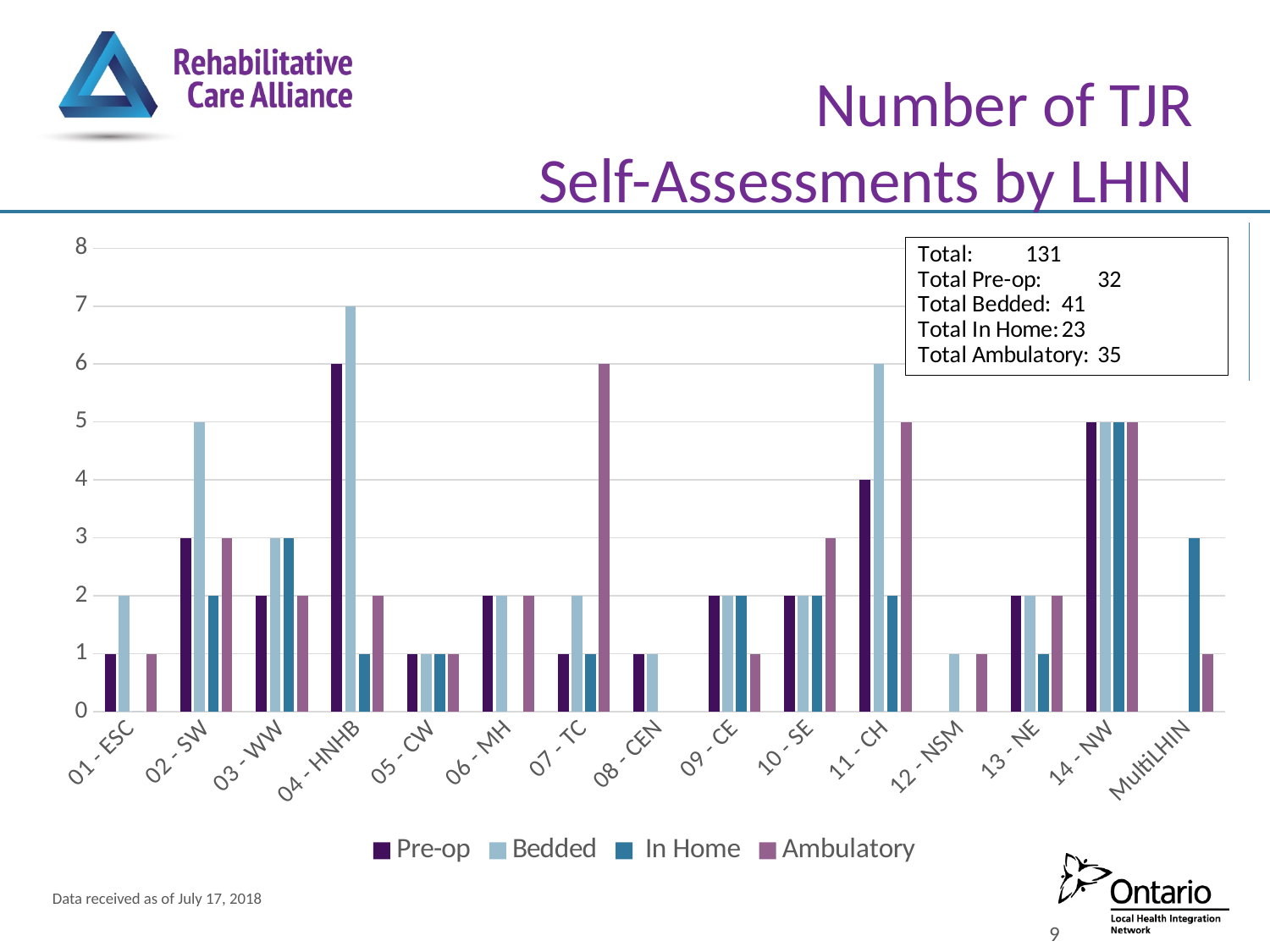
How many LHIN categories are shown along the x axis? 15 Which LHIN has the highest Bedded value? 04 - HNHB How many series does the legend list? 4 What is the Bedded value for 04 - HNHB? 7 Which is larger for 02 - SW, the Bedded value or the In Home value? Bedded What is the title of the chart? Number of TJR Self-Assessments by LHIN What kind of chart is shown on the slide? bar chart What is the difference between the Bedded value and the Pre-op value for 04 - HNHB? 1 What is the Pre-op value for 11 - CH? 4 What is the In Home value for MultiLHIN? 3 According to the text box, what is the total number of TJR self-assessments? 131 What is the Ambulatory value for 07 - TC? 6